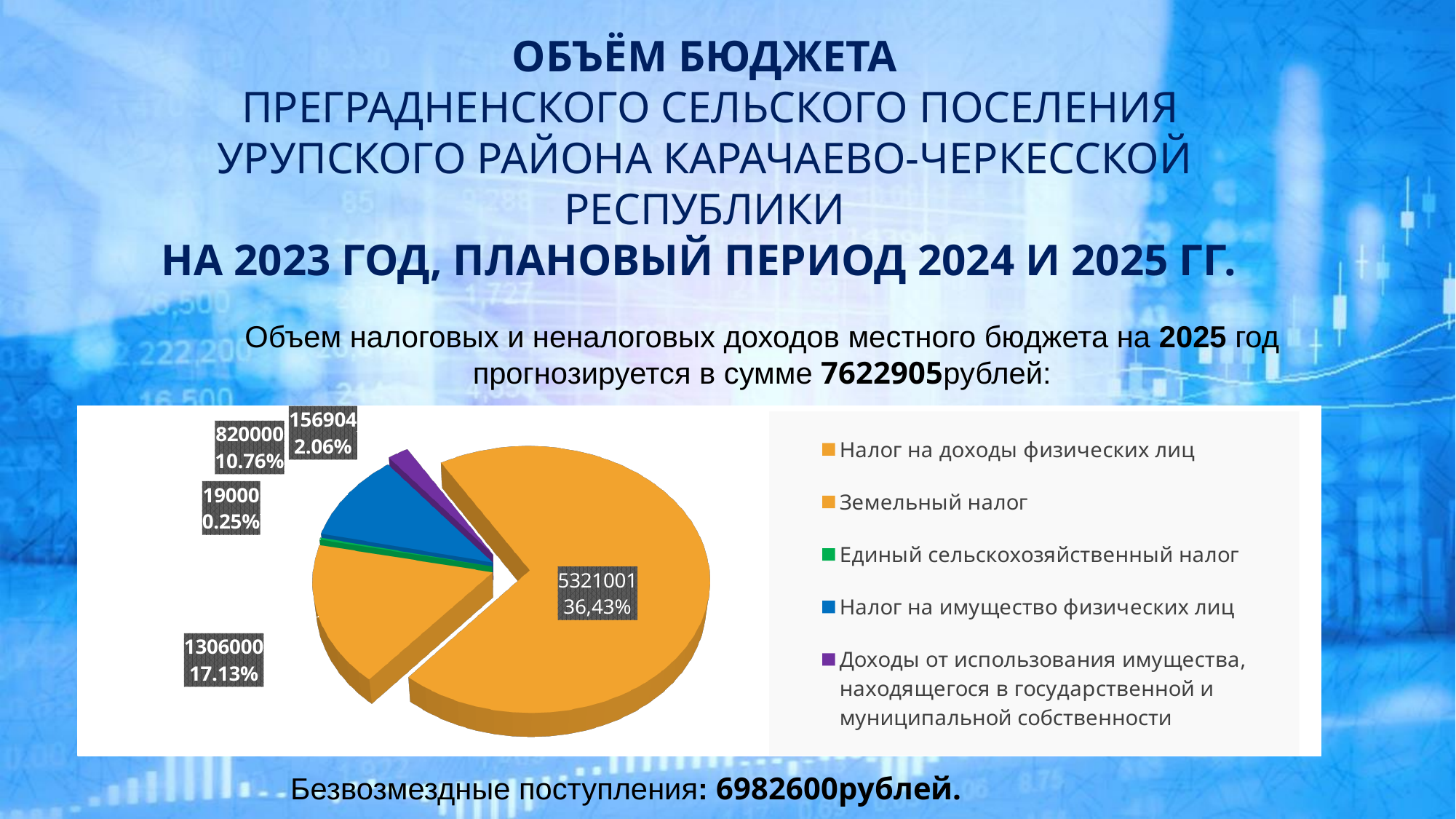
What value is shown for Налог на имущество физических лиц in the pie chart? 820000 What value is shown for Налог на доходы физических лиц in the pie chart? 5321001 Which category has the largest slice in the pie chart? Налог на доходы физических лиц What percentage share is shown for Налог на доходы физических лиц in the pie chart? 36,43% What percentage share is shown for Доходы от использования имущества, находящегося в государственной и муниципальной собственности? 2.06% How many slices does the pie chart have? 5 What kind of chart is shown on the slide? Pie chart Which category has the smallest slice in the pie chart? Единый сельскохозяйственный налог What value is shown for Единый сельскохозяйственный налог in the pie chart? 19000 What is the difference between the values for Налог на доходы физических лиц and Земельный налог? 4015001 What value is shown for Земельный налог in the pie chart? 1306000 How many entries does the legend of the pie chart list? 5